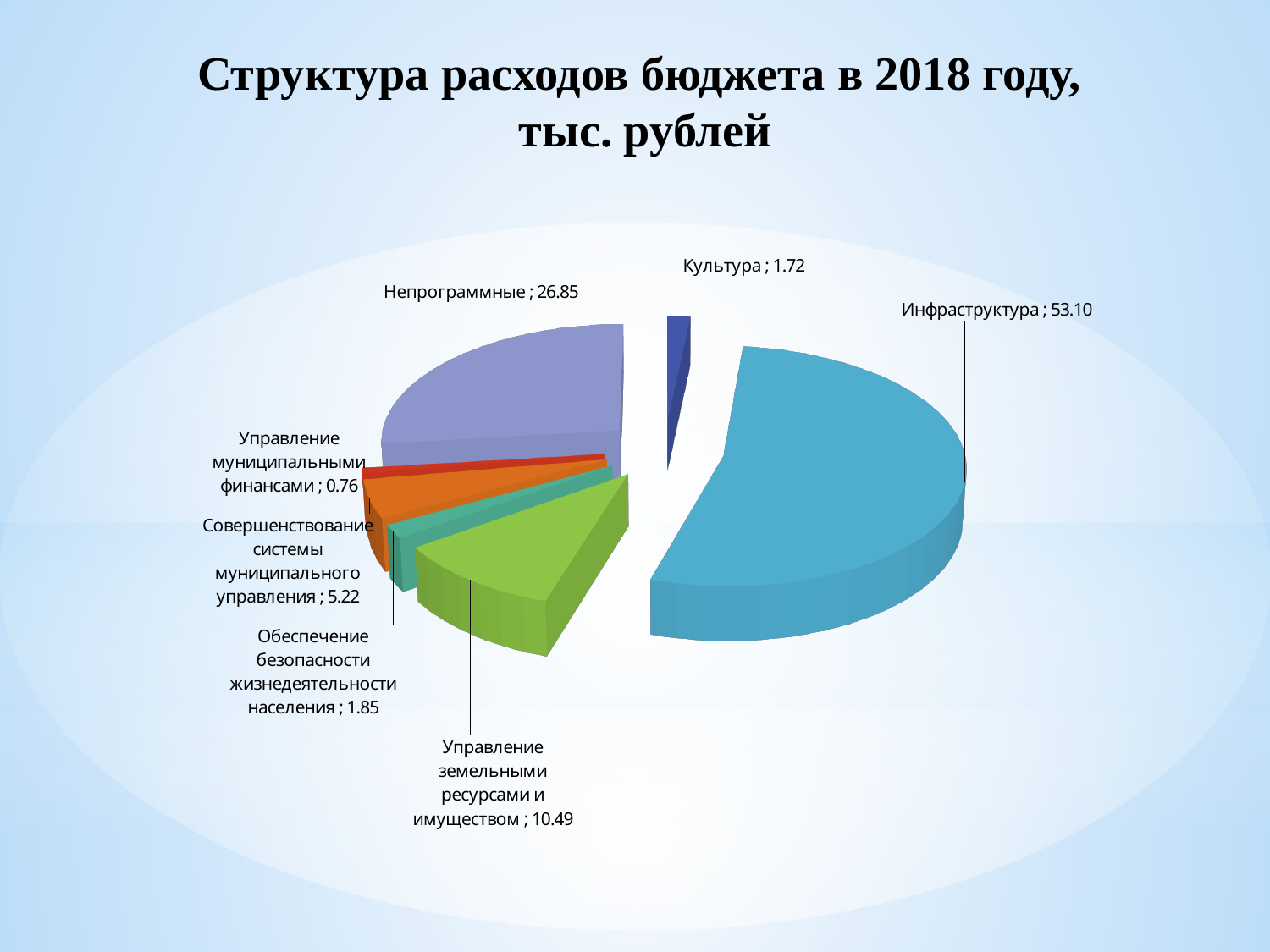
What is the title of the chart on the slide? Структура расходов бюджета в 2018 году, тыс. рублей What is the value for Управление земельными ресурсами и имуществом? 10.49 Which category has the largest slice of the pie? Инфраструктура What is the value for Культура? 1.72 How many slices does the pie chart have? 7 Which category has the smallest slice of the pie? Управление муниципальными финансами Which is larger: Совершенствование системы муниципального управления or Обеспечение безопасности жизнедеятельности населения? Совершенствование системы муниципального управления What is the value for Управление муниципальными финансами? 0.76 What is the value for Инфраструктура? 53.10 What is the value for Непрограммные? 26.85 What type of chart is shown on the slide? Pie chart What is the difference between the values for Инфраструктура and Непрограммные? 26.25